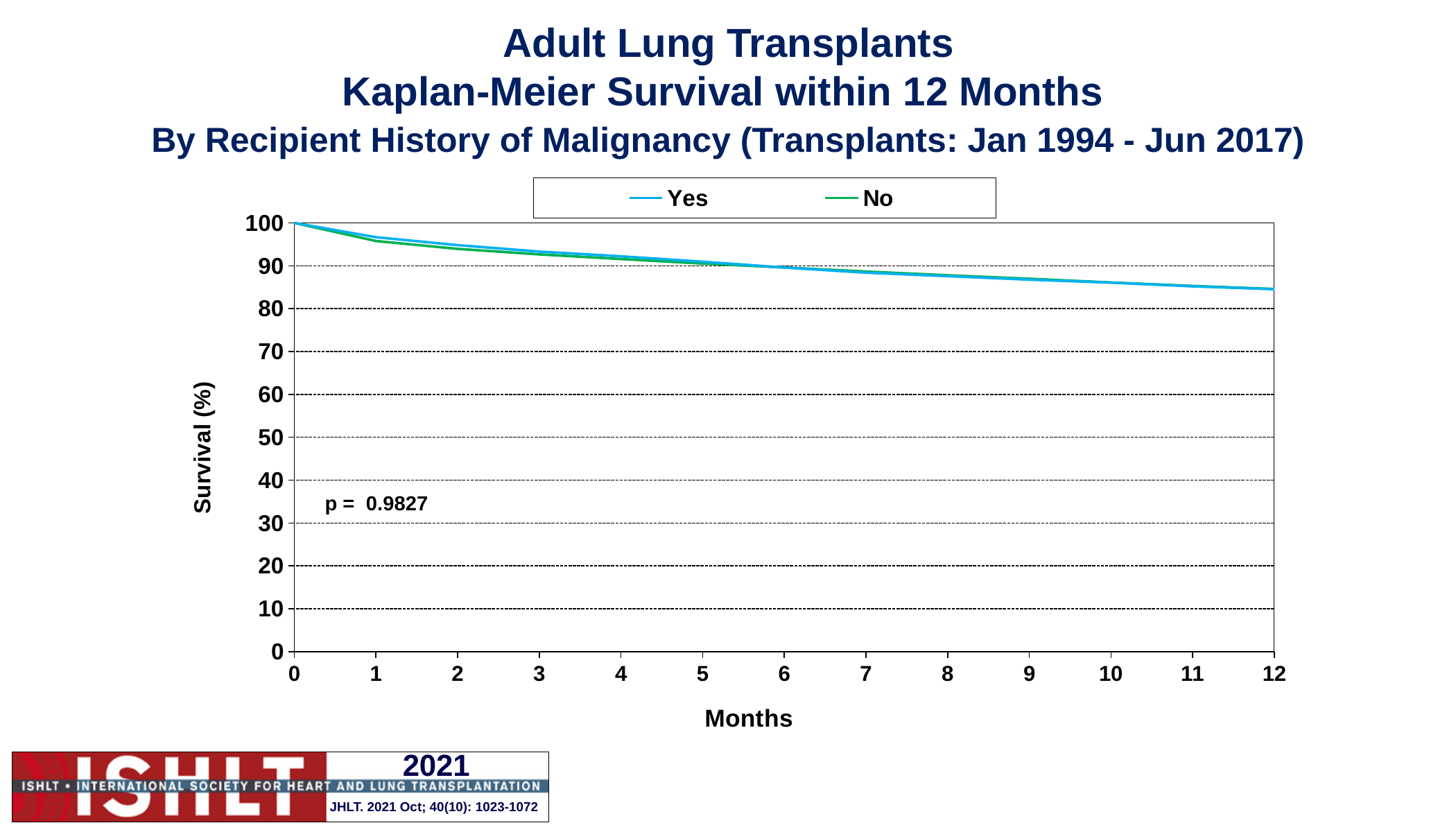
Is the survival value for the No group at 12 months greater or less than 90? less What is the p-value printed on the chart? p = 0.9827 Is the survival value for the Yes group at 12 months greater or less than 80? greater What are the two series named in the legend? Yes and No What kind of chart is shown on the slide? line chart What is the survival value for both groups at month 0? 100 Is the survival value for the No group at 6 months greater or less than 80? greater Do the survival curves rise or fall as months increase? fall How many series does the legend list? 2 What is the maximum value shown on the x axis? 12 What is the label of the y axis? Survival (%)